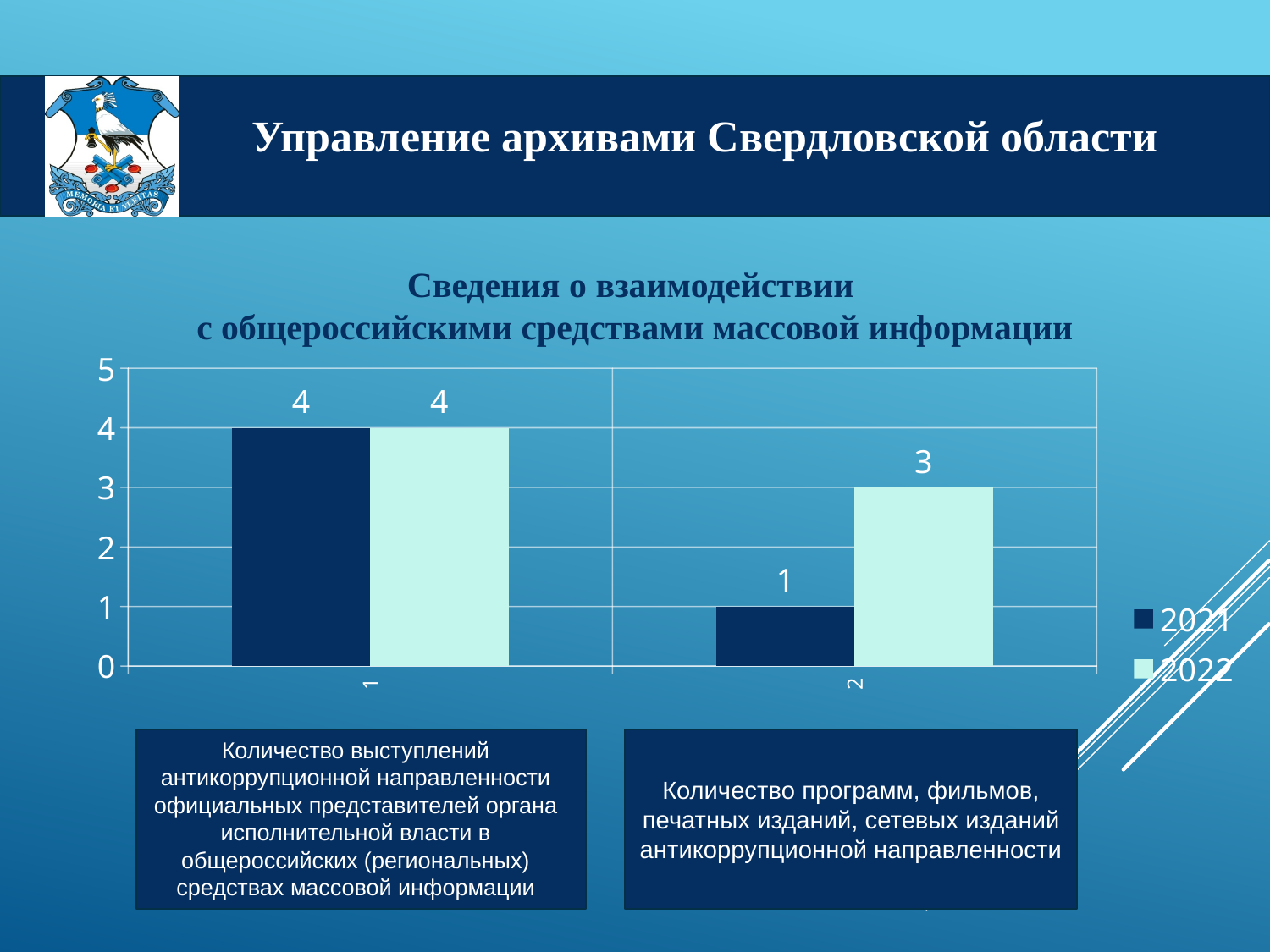
What is the 2021 value for category 1 (количество выступлений антикоррупционной направленности)? 4 For category 2, which year has the larger value, 2021 or 2022? 2022 How many categories are shown on the x axis? 2 What is the 2021 value for category 2 (количество программ, фильмов, печатных изданий, сетевых изданий)? 1 What is the 2022 value for category 1 (количество выступлений антикоррупционной направленности)? 4 What is the title of the chart? Сведения о взаимодействии с общероссийскими средствами массовой информации Which category has the lowest value in the 2021 series? 2 What is the 2022 value for category 2 (количество программ, фильмов, печатных изданий, сетевых изданий)? 3 What type of chart is shown on the slide? bar chart How many series does the legend list? 2 What is the difference between the 2022 and 2021 values for category 2? 2 Which years are listed in the legend? 2021 and 2022